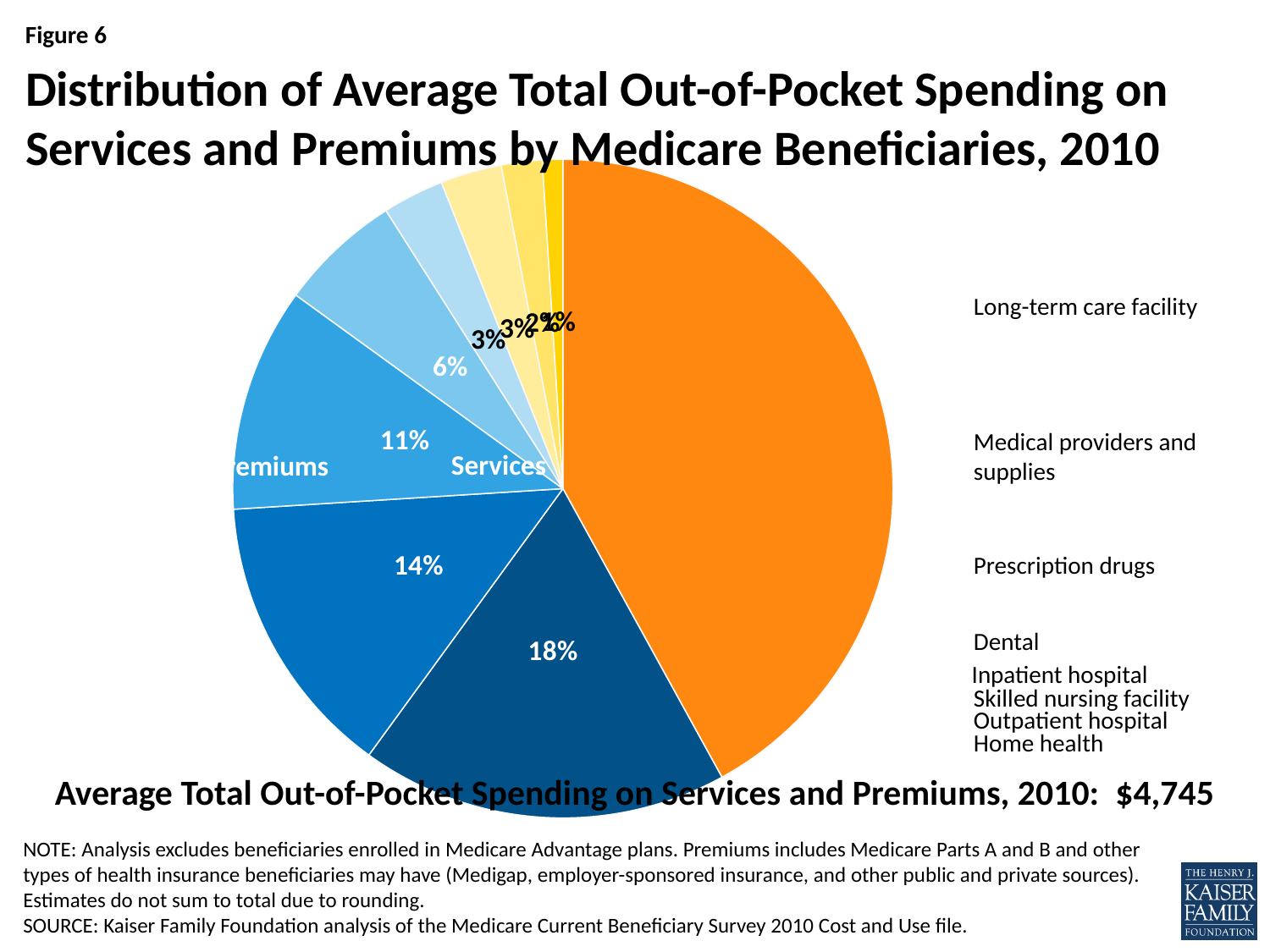
Which is larger, the orange Premiums slice or the 18% Services slice? Premiums What kind of chart is shown on the slide? pie chart What figure number is given for this chart? Figure 6 What percentage is printed on the dark blue slice at the bottom of the pie chart? 18% How many service category labels are listed to the right of the pie chart? 8 Which is larger, the slice labelled 14% or the slice labelled 11%? 14% What are the two main groups labelled inside the pie chart? Premiums and Services What is the largest percentage printed on any slice of the pie chart? 18% What is the difference between the 18% slice and the 14% slice? 4 percentage points Is the orange Premiums slice greater or less than 25% of the pie? greater What is the average total out-of-pocket spending on services and premiums in 2010 stated on the slide? $4,745